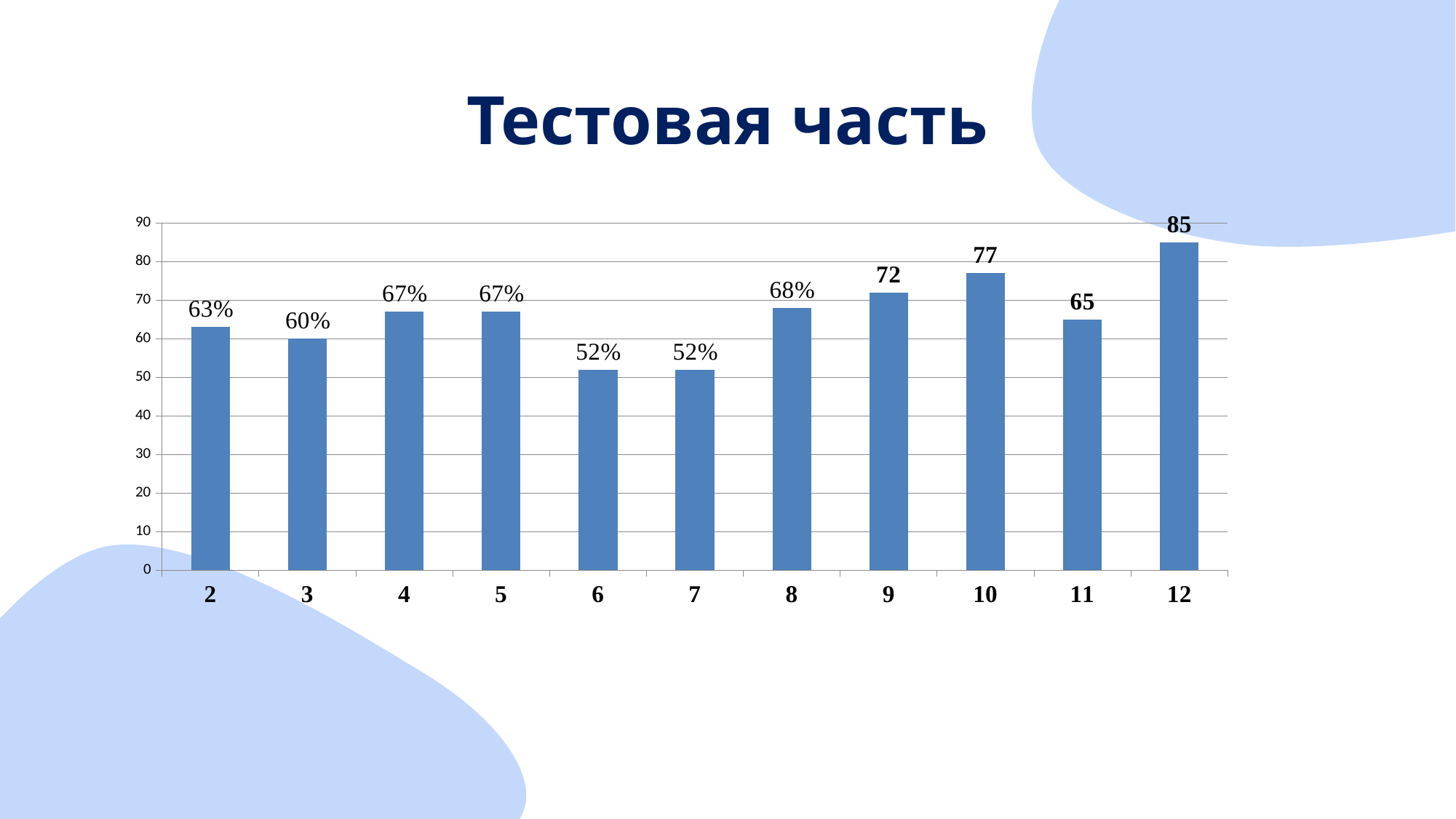
What is the value for category 8? 68% Which categories have the lowest value? 6 and 7 What is the title of the slide? Тестовая часть What is the value for category 10? 77 What is the value for category 2? 63% Which is larger, the value for category 9 or the value for category 3? 9 How many categories are shown on the x axis? 11 What is the difference between the values for category 12 and category 11? 20 What is the value for category 12? 85 Which category has the highest value? 12 What kind of chart is shown on the slide? bar chart Is the value for category 6 greater or less than 60? less